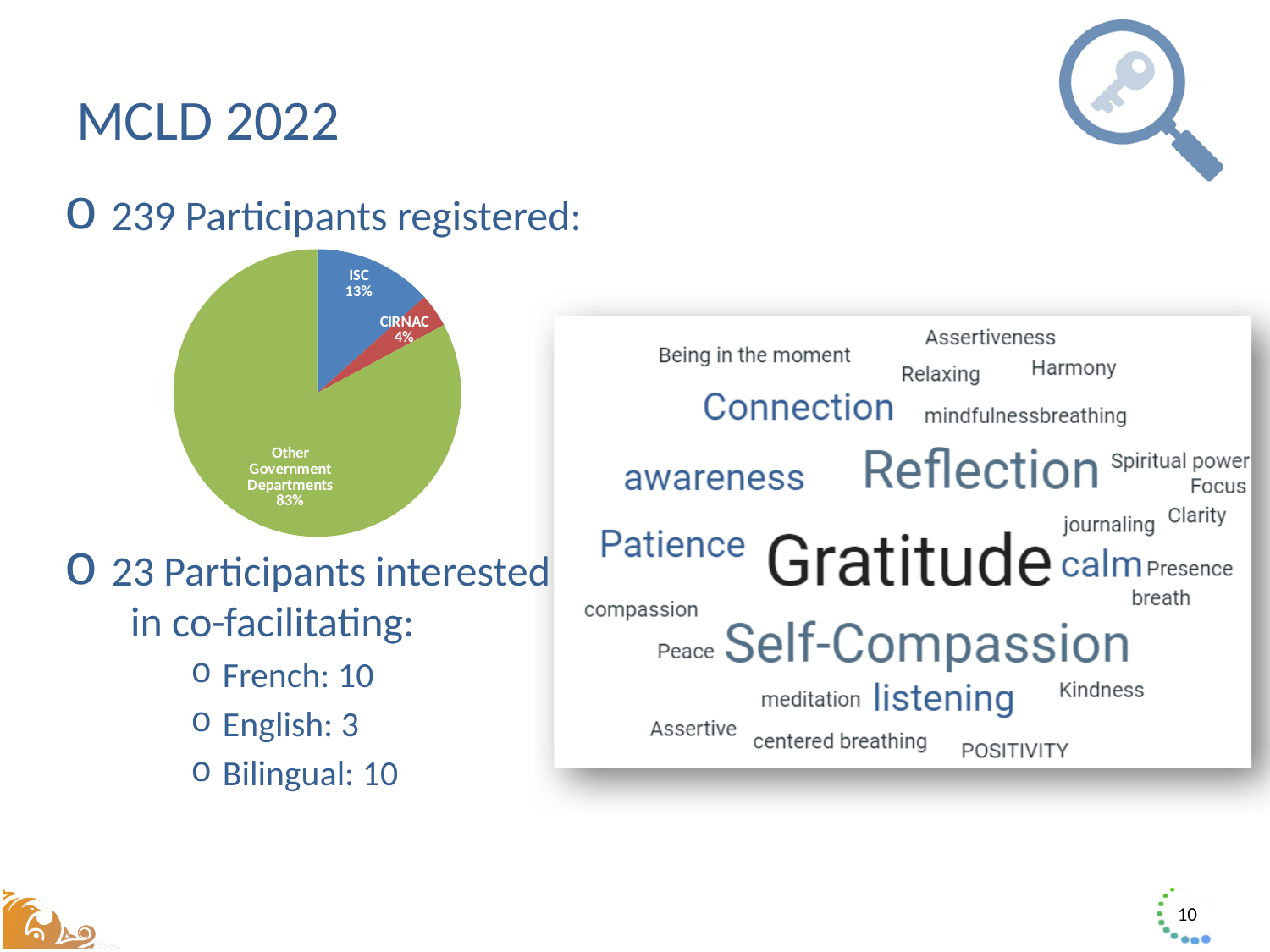
In the pie chart, which is larger, ISC or CIRNAC? ISC Which slice of the pie chart is the smallest? CIRNAC How many slices does the pie chart have? 3 What share of the pie chart is ISC? 13% What kind of chart is shown on the slide? pie chart Which slice of the pie chart is the largest? Other Government Departments What share of the pie chart is CIRNAC? 4% What colour is the ISC slice in the pie chart? blue What colour is the Other Government Departments slice in the pie chart? green What share of the pie chart is Other Government Departments? 83% What is the difference in percentage points between the Other Government Departments and ISC slices? 70 What is the difference in percentage points between the ISC and CIRNAC slices? 9